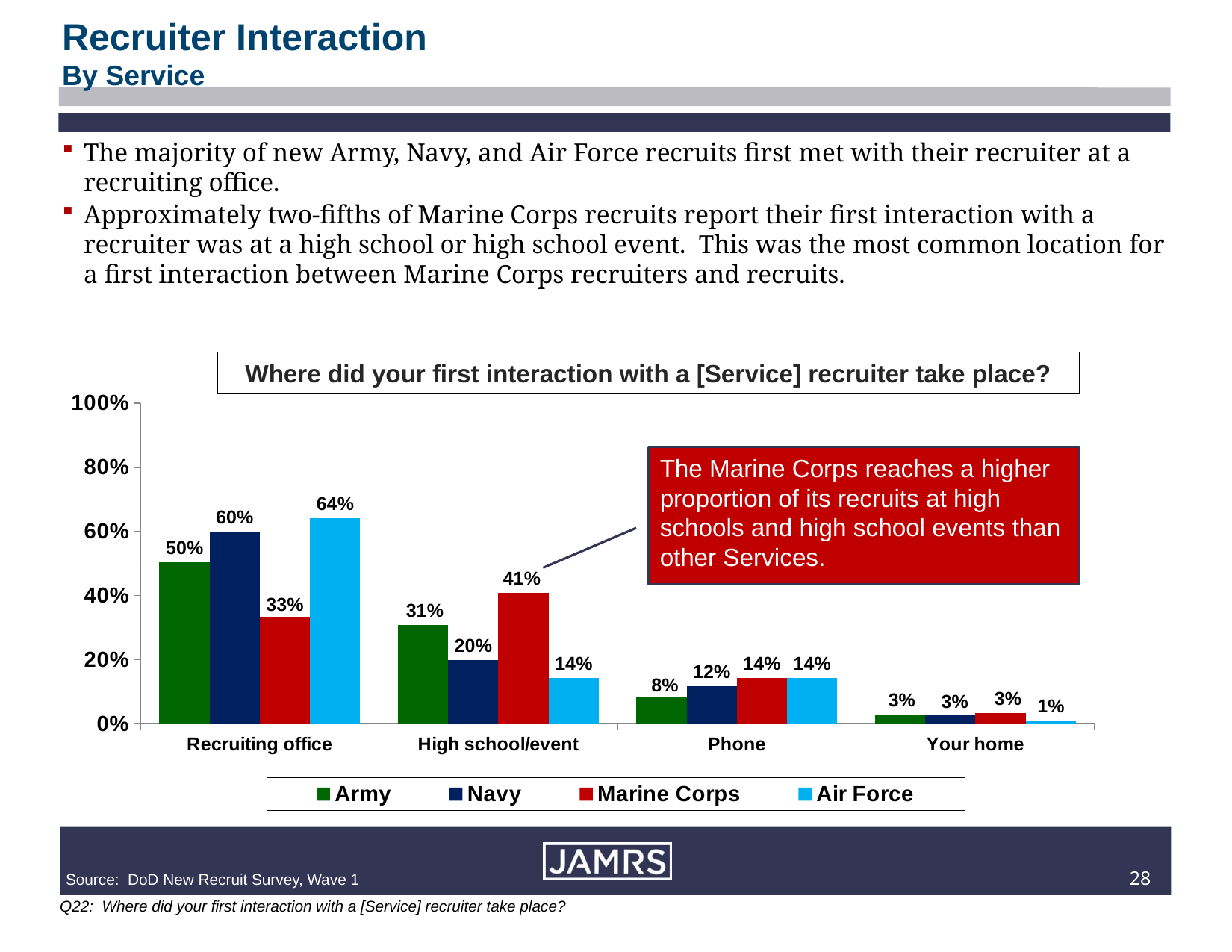
Which service has the lowest value for Your home? Air Force What percentage of Air Force recruits first interacted with a recruiter at a recruiting office? 64% What is the title of the chart? Where did your first interaction with a [Service] recruiter take place? What is the Army value for Phone? 8% What is the Marine Corps value for High school/event? 41% What kind of chart is shown on the slide? Bar chart Is the Army value for Recruiting office greater or less than 40%? greater What is the difference between the Navy and Marine Corps values for Recruiting office? 27% Which is larger for High school/event: the Army value or the Navy value? Army Which service has the highest value for Recruiting office? Air Force How many location categories are shown on the x axis? 4 How many series does the legend list? 4